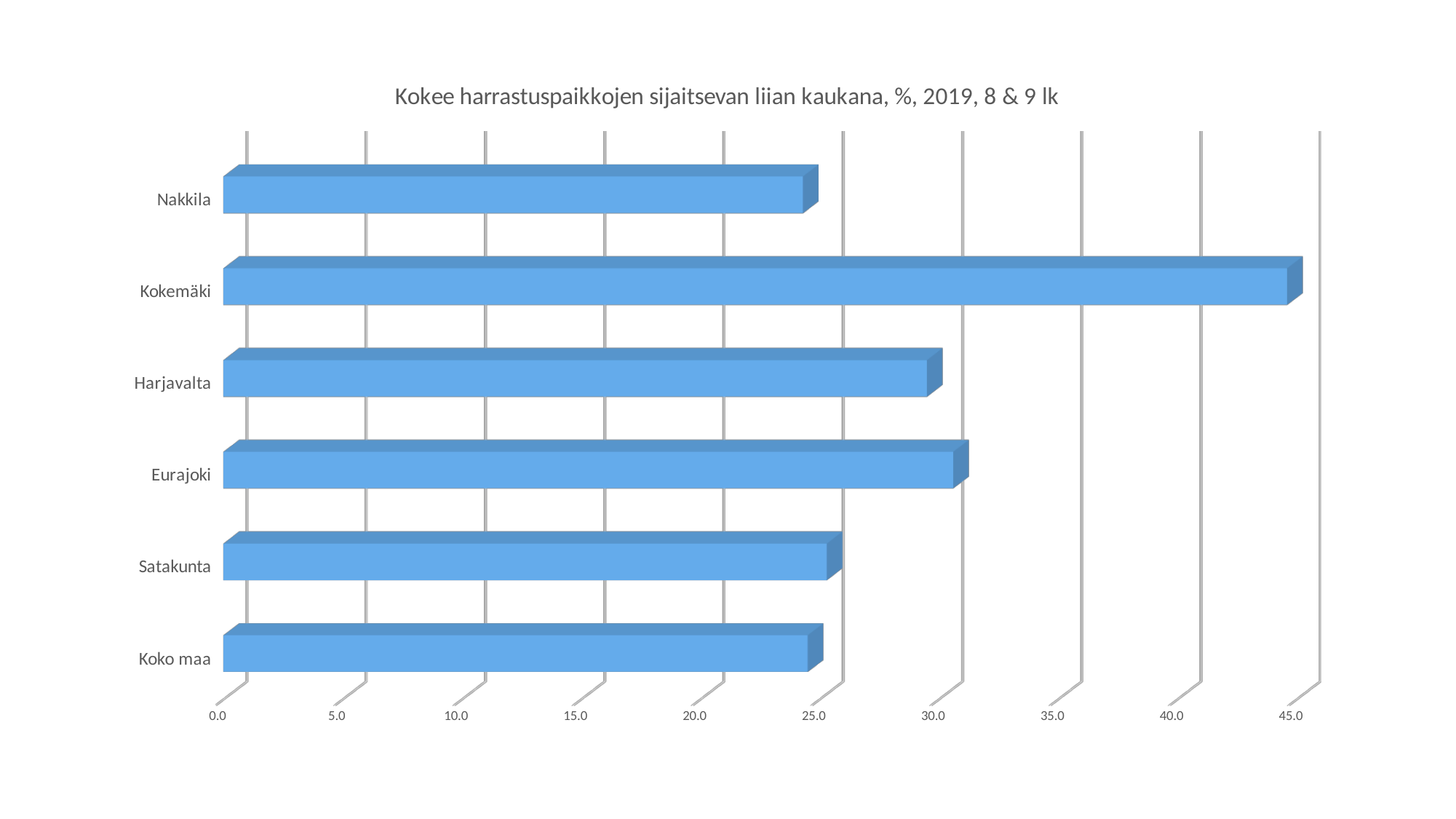
Is the value for Harjavalta greater or less than 25? greater What kind of chart is shown on the slide? bar chart Which is larger, the value for Eurajoki or the value for Satakunta? Eurajoki What is the title of the chart? Kokee harrastuspaikkojen sijaitsevan liian kaukana, %, 2019, 8 & 9 lk Is the value for Nakkila greater or less than 30? less Is the value for Koko maa greater or less than 20? greater How many categories are shown in the chart? 6 Which is larger, the value for Kokemäki or the value for Harjavalta? Kokemäki Which category has the highest value in the chart? Kokemäki Which is larger, the value for Harjavalta or the value for Nakkila? Harjavalta